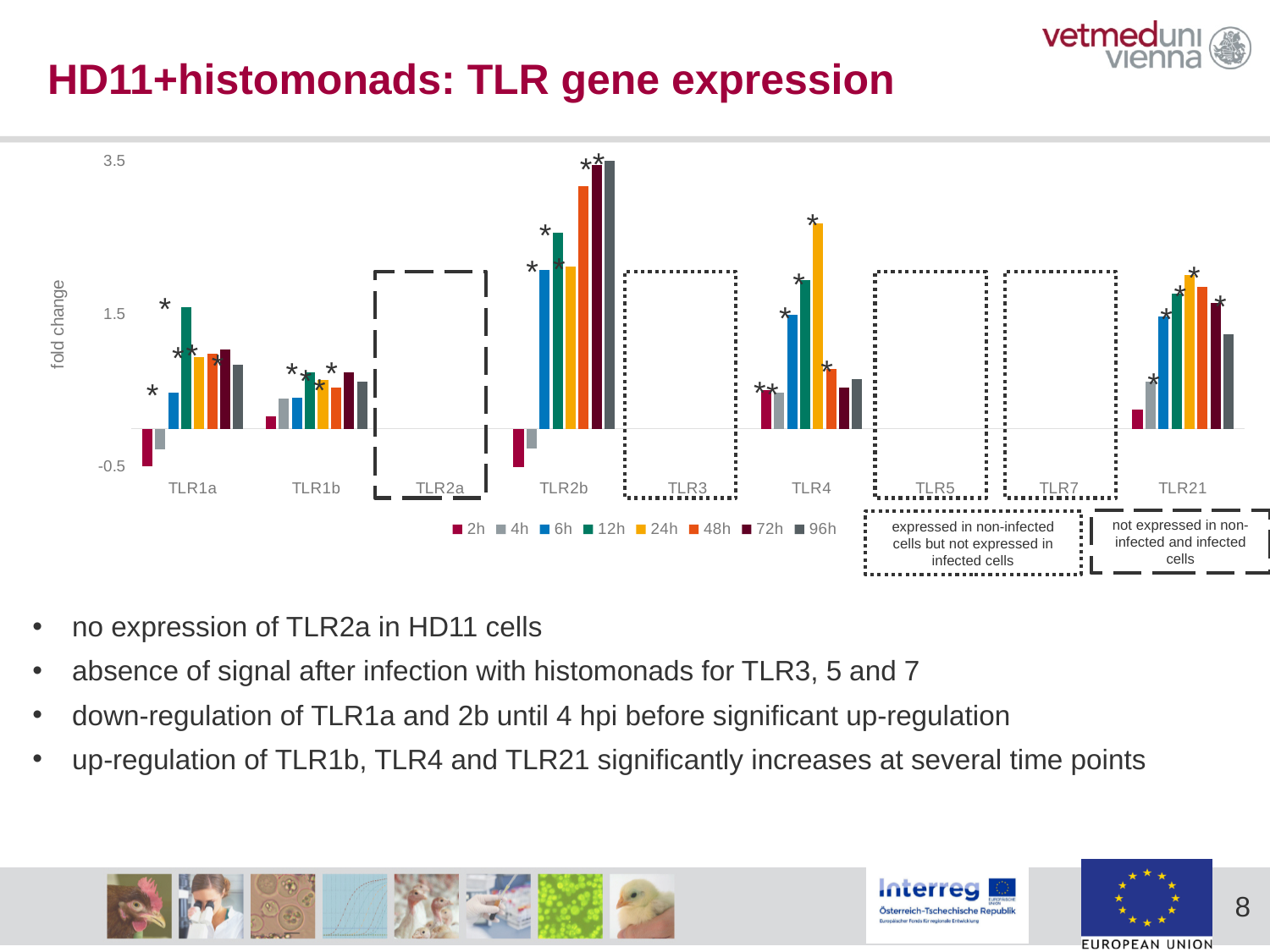
Which time point is the first entry in the legend? 2h What is the label of the y axis? fold change Which time point has the highest value within the TLR4 group? 24h Is the value for 48h in TLR2b greater or less than 1.5? greater How many series does the legend list? 8 Is the value for 24h in TLR4 greater or less than 1.5? greater How many categories are labelled on the x axis? 9 Is the value for 12h in TLR1b greater or less than 1.5? less Which is larger, the 96h value for TLR2b or the 96h value for TLR4? TLR2b Which time point has the highest value within the TLR1a group? 12h What kind of chart is shown on the slide? bar chart